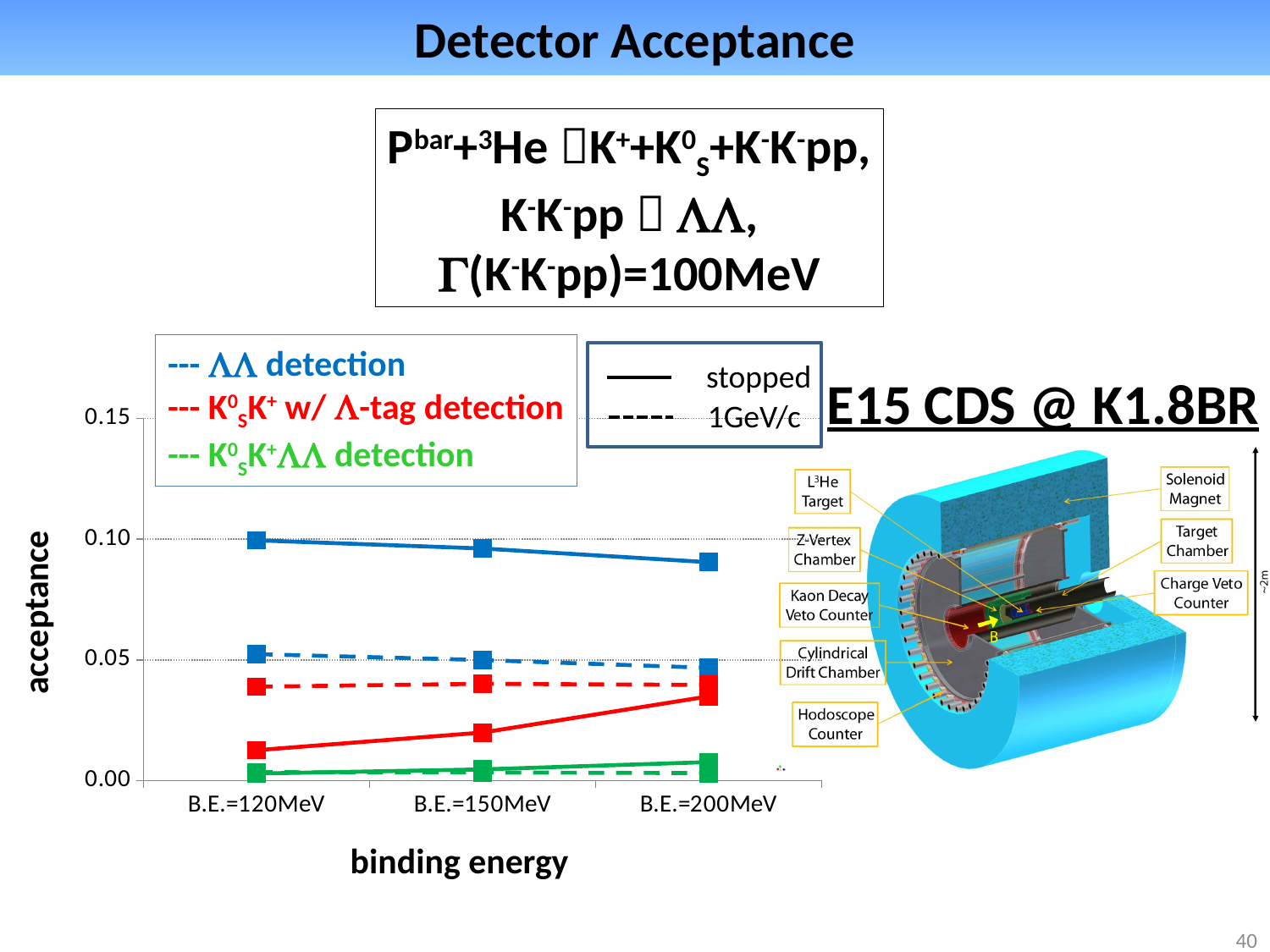
At B.E.=120MeV, which has the higher acceptance: the solid blue line (ΛΛ detection) or the solid red line (K0sK+ w/ Λ-tag detection)? solid blue line (ΛΛ detection) Is the acceptance of the solid blue line (ΛΛ detection, stopped) at B.E.=200MeV greater or less than 0.05? greater What kind of chart is shown on the slide? line chart How many detection modes does the coloured legend of the chart list? 3 At which binding energy does the solid red line (K0sK+ w/ Λ-tag detection, stopped) reach its highest acceptance? B.E.=200MeV Is the acceptance of the solid red line (K0sK+ w/ Λ-tag detection, stopped) at B.E.=120MeV greater or less than 0.05? less Does the solid red line (K0sK+ w/ Λ-tag detection, stopped) rise or fall as binding energy increases from B.E.=120MeV to B.E.=200MeV? rise What is the label of the y axis of the chart? acceptance Is the acceptance of the dashed red line (K0sK+ w/ Λ-tag detection, 1GeV/c) at B.E.=150MeV greater or less than 0.05? less Does the solid blue line (ΛΛ detection, stopped) rise or fall as binding energy increases from B.E.=120MeV to B.E.=200MeV? fall How many binding energy categories are shown on the x axis of the chart? 3 What is the label of the x axis of the chart? binding energy